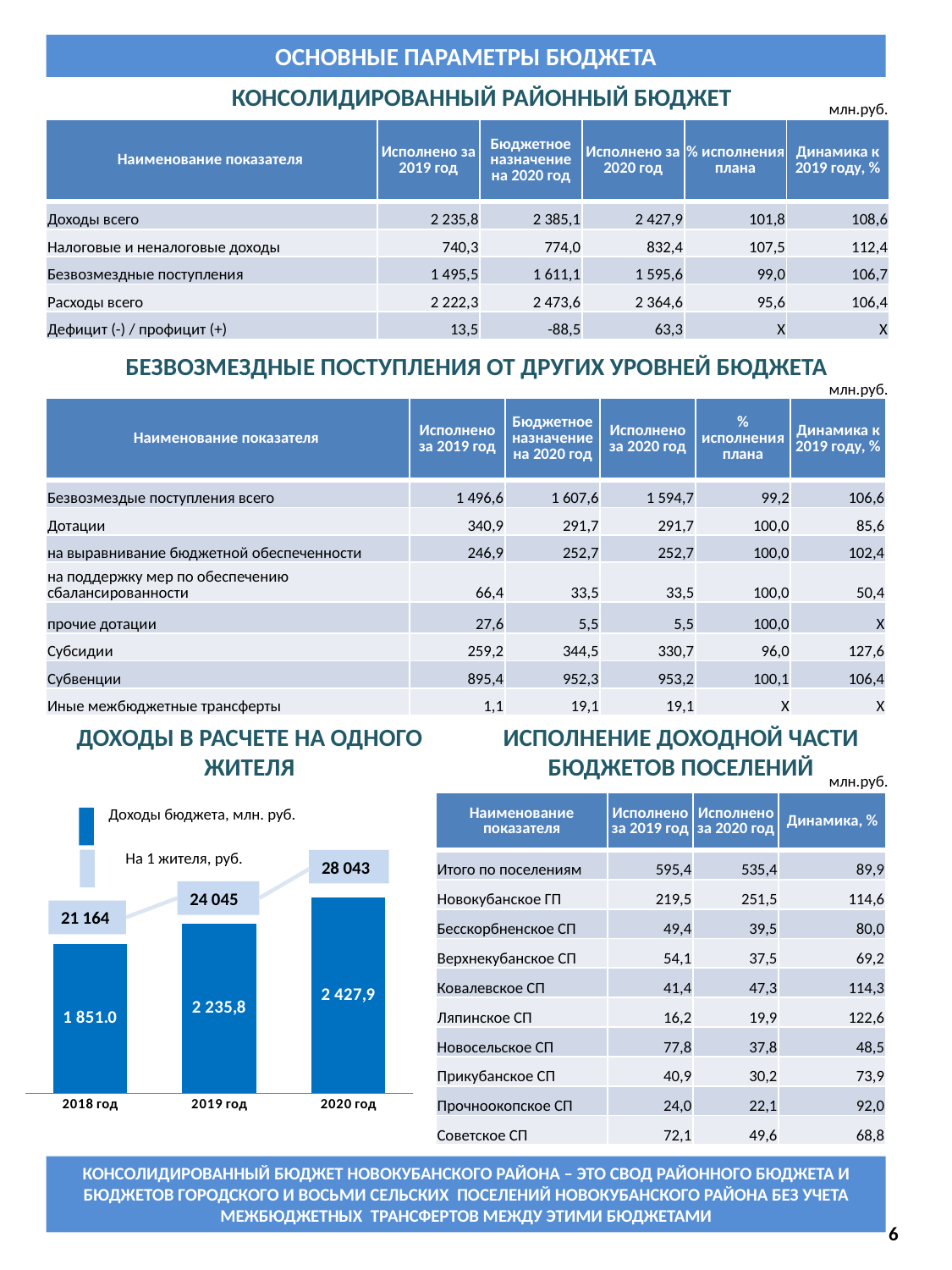
In the chart "ДОХОДЫ В РАСЧЕТЕ НА ОДНОГО ЖИТЕЛЯ", how many years are shown on the x axis? 3 In the chart "ДОХОДЫ В РАСЧЕТЕ НА ОДНОГО ЖИТЕЛЯ", what is the value of "Доходы бюджета, млн. руб." for 2019 год? 2 235,8 In the chart "ДОХОДЫ В РАСЧЕТЕ НА ОДНОГО ЖИТЕЛЯ", how many series does the legend list? 2 What kind of chart is "ДОХОДЫ В РАСЧЕТЕ НА ОДНОГО ЖИТЕЛЯ"? Bar chart In the chart "ДОХОДЫ В РАСЧЕТЕ НА ОДНОГО ЖИТЕЛЯ", what is the value of "Доходы бюджета, млн. руб." for 2020 год? 2 427,9 In the chart "ДОХОДЫ В РАСЧЕТЕ НА ОДНОГО ЖИТЕЛЯ", which year has the lowest value of "На 1 жителя, руб."? 2018 год In the chart "ДОХОДЫ В РАСЧЕТЕ НА ОДНОГО ЖИТЕЛЯ", what is the difference in "На 1 жителя, руб." between 2020 год and 2019 год? 3 998 In the chart "ДОХОДЫ В РАСЧЕТЕ НА ОДНОГО ЖИТЕЛЯ", what is the value of "На 1 жителя, руб." for 2020 год? 28 043 In the chart "ДОХОДЫ В РАСЧЕТЕ НА ОДНОГО ЖИТЕЛЯ", which year has the highest value of "Доходы бюджета, млн. руб."? 2020 год In the chart "ДОХОДЫ В РАСЧЕТЕ НА ОДНОГО ЖИТЕЛЯ", what is the value of "На 1 жителя, руб." for 2018 год? 21 164 In the chart "ДОХОДЫ В РАСЧЕТЕ НА ОДНОГО ЖИТЕЛЯ", which is larger for "Доходы бюджета, млн. руб.": 2018 год or 2019 год? 2019 год In the chart "ДОХОДЫ В РАСЧЕТЕ НА ОДНОГО ЖИТЕЛЯ", do the values of "Доходы бюджета, млн. руб." rise or fall from 2018 год to 2020 год? Rise